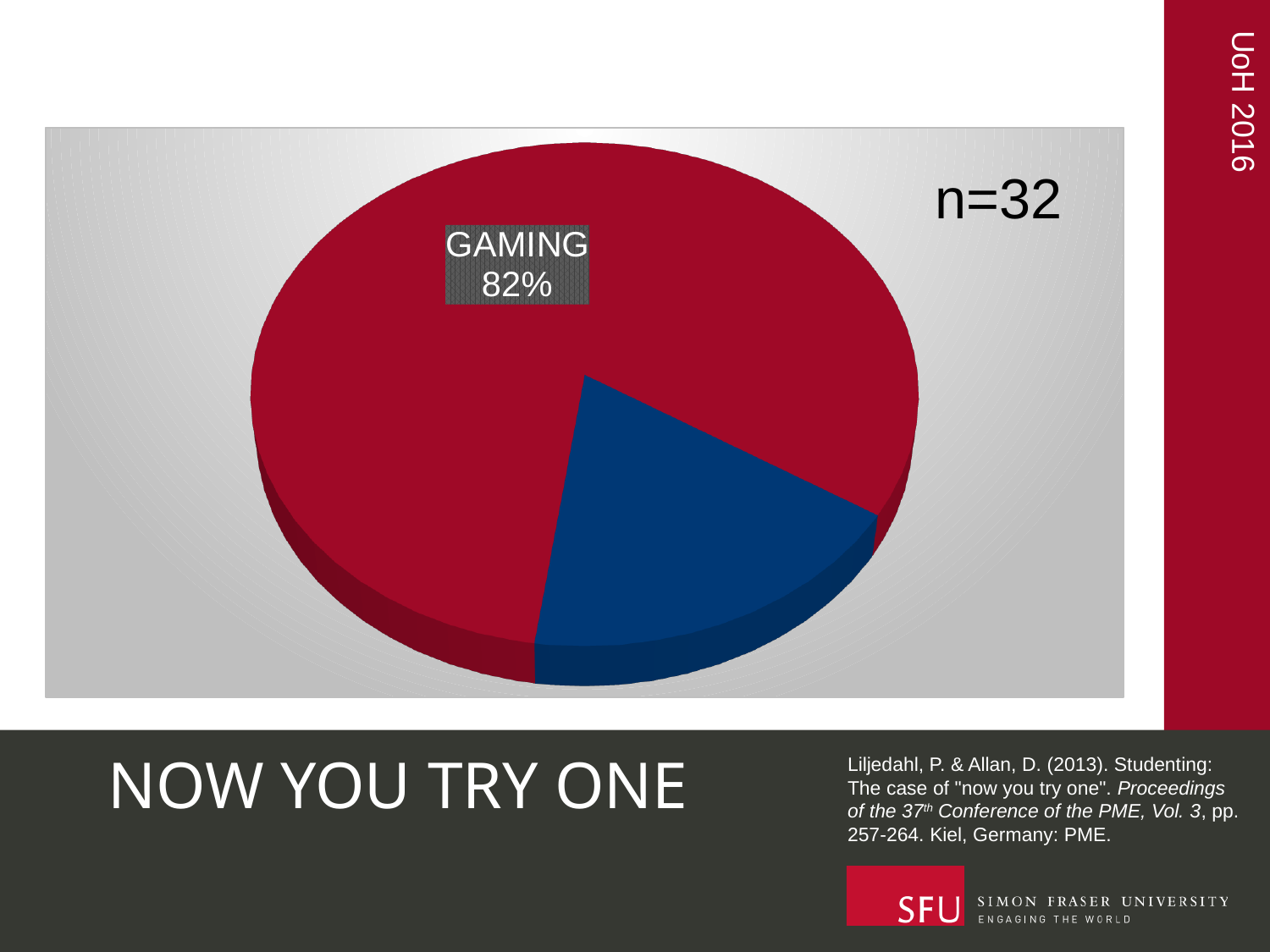
What kind of chart is shown on the slide? pie chart How many slices does the pie chart have? 2 Which is larger: the GAMING slice or the blue slice? GAMING What share of the pie does the GAMING slice represent? 82% What colour is the GAMING slice of the pie chart? red What is the sample size (n) shown next to the pie chart? n=32 Which slice of the pie chart is the largest? GAMING